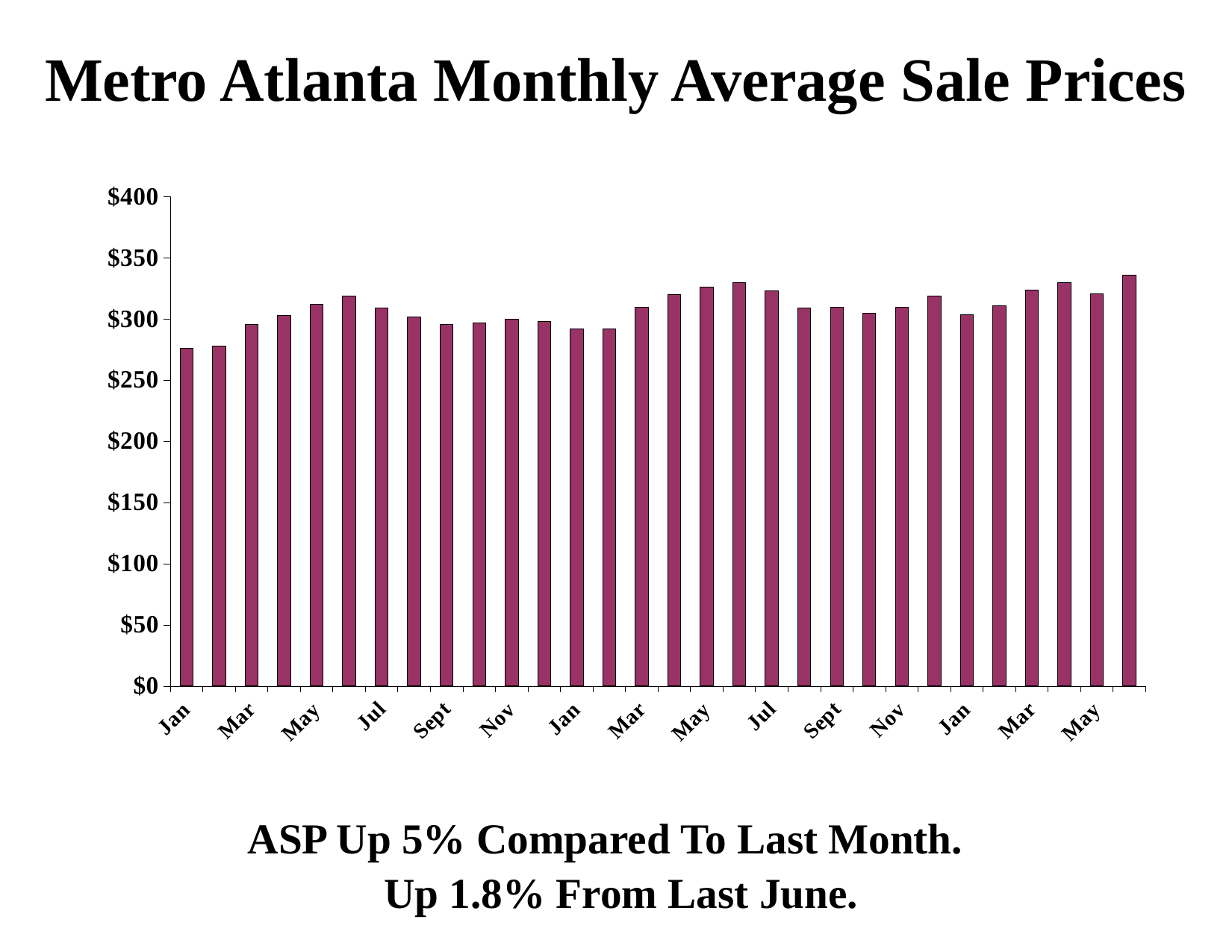
Which is larger, the first Jan bar or the last bar on the right? the last bar on the right Is the value for the last bar on the right greater or less than $300? greater Is the value for the first Jan bar greater or less than $300? less What is the highest value shown on the y axis? $400 What kind of chart is shown on the slide? bar chart Is the value for the first May bar greater or less than $300? greater Do the values generally rise or fall from the first bar to the last bar? rise What is the title of the chart? Metro Atlanta Monthly Average Sale Prices How many bars are plotted in the chart? 30 Which is larger, the first Jan bar or the first May bar? the first May bar